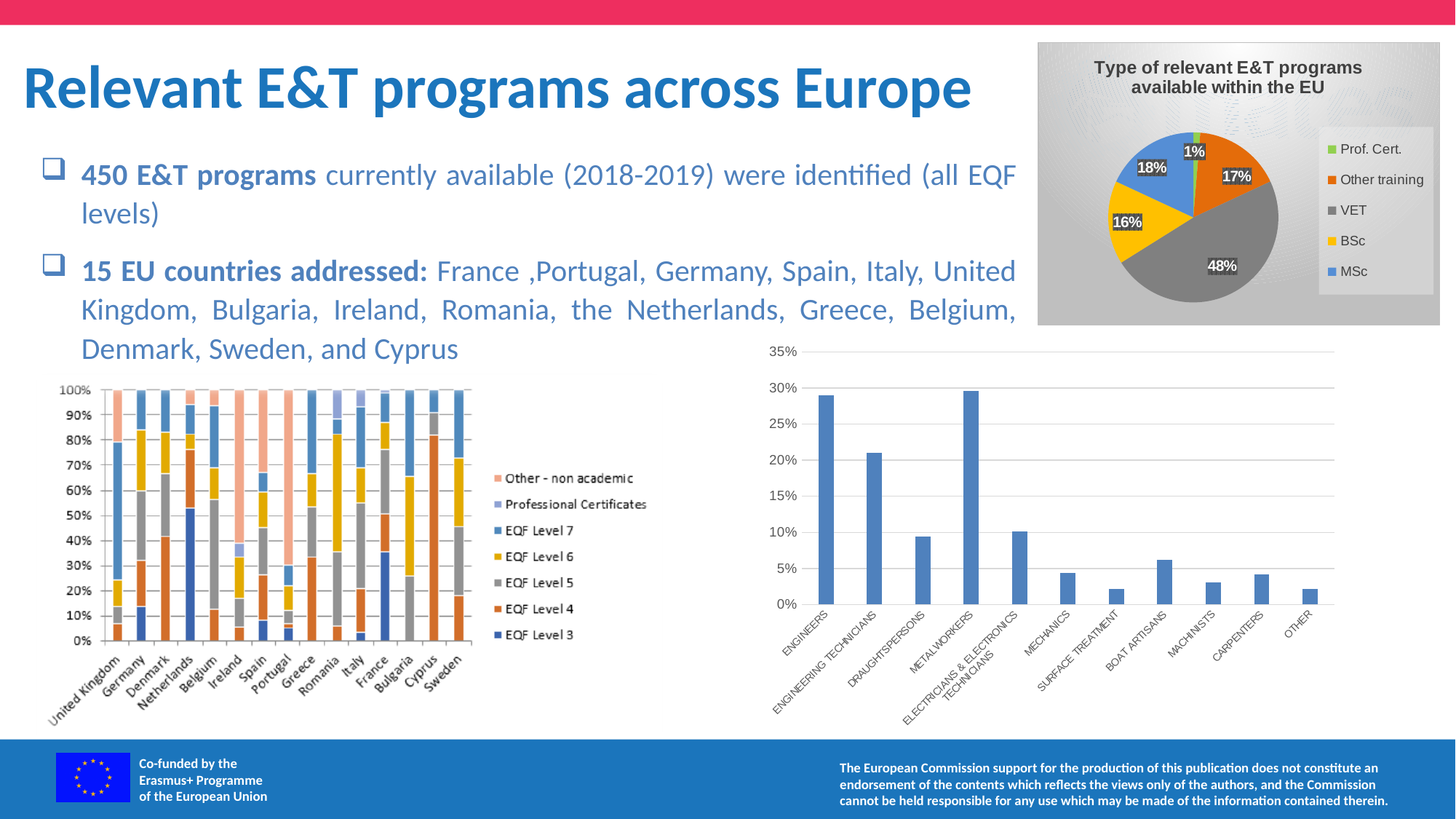
In the pie chart titled 'Type of relevant E&T programs available within the EU', what is the difference between the Other training share and the BSc share? 1% In the stacked bar chart at the bottom left of the slide, how many series does the legend list? 7 In the pie chart titled 'Type of relevant E&T programs available within the EU', which category has the smallest share? Prof. Cert. In the pie chart titled 'Type of relevant E&T programs available within the EU', what share is MSc? 18% In the bar chart at the bottom right of the slide, how many occupation categories are shown on the x axis? 11 In the pie chart titled 'Type of relevant E&T programs available within the EU', how many categories does the legend list? 5 In the stacked bar chart at the bottom left of the slide, how many countries are shown on the x axis? 15 In the pie chart titled 'Type of relevant E&T programs available within the EU', which category has the largest share? VET In the bar chart at the bottom right of the slide, which is larger, the value for ENGINEERING TECHNICIANS or the value for MECHANICS? ENGINEERING TECHNICIANS In the bar chart at the bottom right of the slide, is the value for ENGINEERS greater or less than 25%? greater In the pie chart titled 'Type of relevant E&T programs available within the EU', what share is VET? 48%